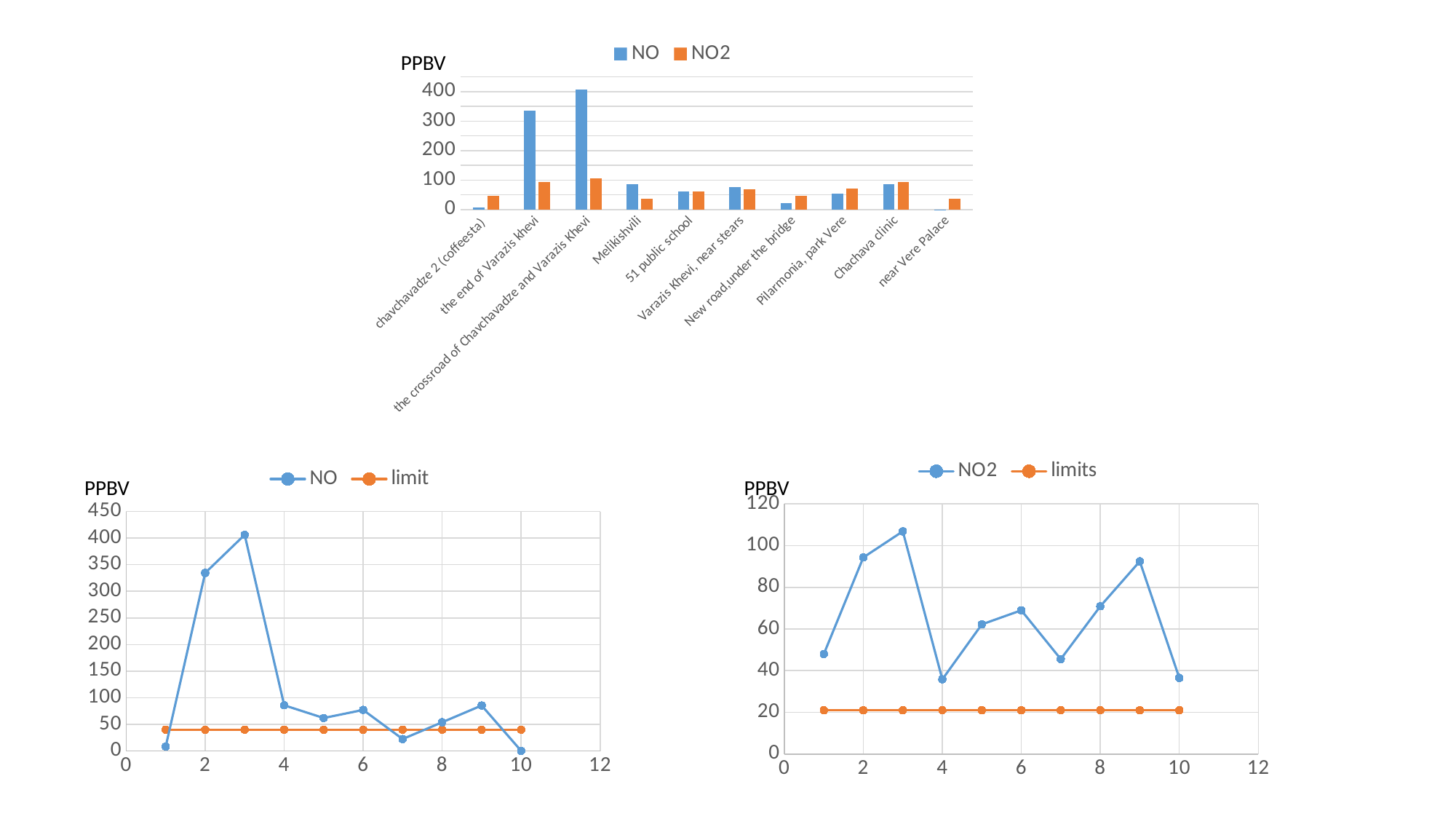
In the bottom-left chart (NO and limit), at which x value does the NO line reach its highest point? 3 What kind of chart is the top chart on the slide? bar chart In the top bar chart, which location has the lowest NO value? near Vere Palace In the top bar chart, at chavchavadze 2 (coffeesta), which is larger: NO or NO2? NO2 In the top bar chart, is the NO value for the end of Varazis khevi greater or less than 300? greater How many series does the legend of the top bar chart list? 2 What is the y-axis unit label shown on the bottom-right chart? PPBV What kind of chart is the bottom-left chart (NO and limit)? line chart How many locations are shown on the x axis of the top bar chart? 10 In the bottom-right chart (NO2 and limits), is the limits line greater or less than 40? less In the top bar chart, which location has the highest NO value? the crossroad of Chavchavadze and Varazis Khevi In the top bar chart, at Melikishvili, which is larger: NO or NO2? NO